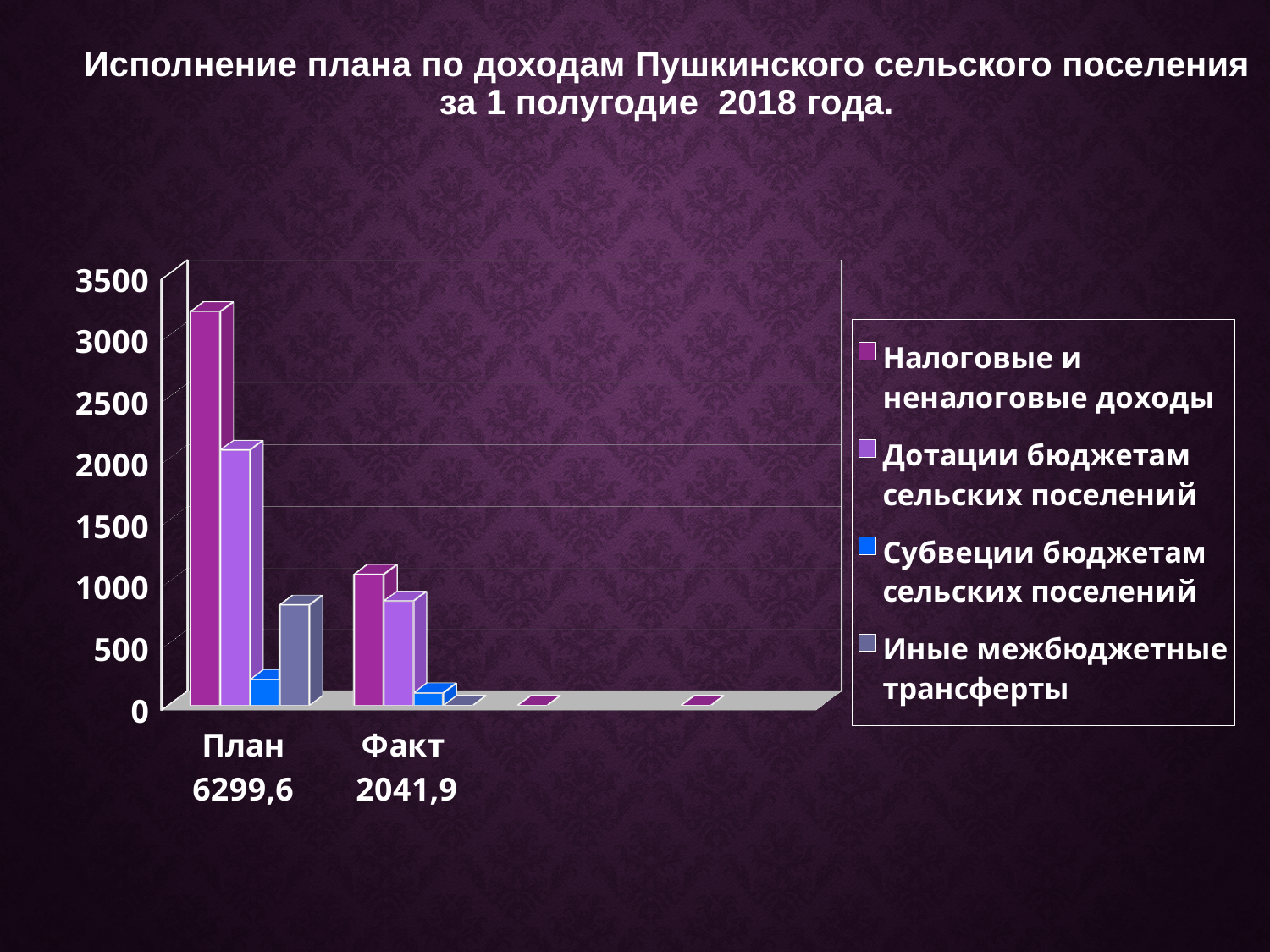
Which series has the highest value in the "План" category? Налоговые и неналоговые доходы What total is printed under the category label "Факт"? 2041,9 How many series does the legend list? 4 Is the value for "Иные межбюджетные трансферты" in the "Факт" category greater or less than 500? less Is the value for "Субвеции бюджетам сельских поселений" in the "План" category greater or less than 500? less Is the value for "Налоговые и неналоговые доходы" in the "Факт" category greater or less than 1000? greater Which is larger: "Налоговые и неналоговые доходы" for "План" or for "Факт"? План Which series is shown in blue in the legend? Субвеции бюджетам сельских поселений What kind of chart is shown on the slide? bar chart What total is printed under the category label "План"? 6299,6